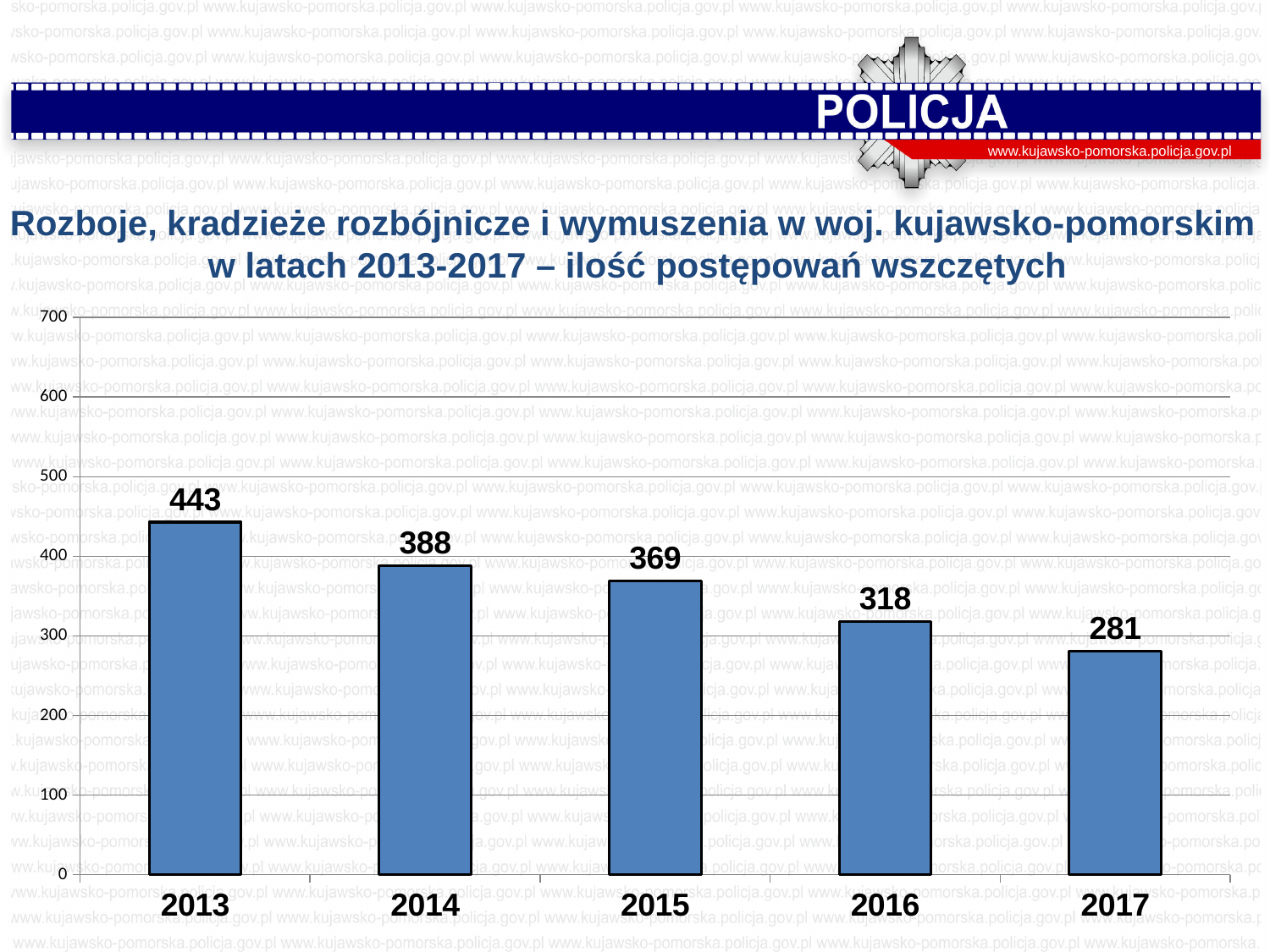
Is the value for 2015 greater or less than 400? less What is the value for 2013? 443 What is the difference between the values for 2016 and 2017? 37 What is the value for 2015? 369 Which year has the highest value? 2013 What is the difference between the values for 2013 and 2014? 55 How many years are shown on the x axis? 5 Do the values rise or fall from 2013 to 2017? fall What kind of chart is shown on the slide? bar chart Which is larger, the value for 2014 or the value for 2016? 2014 What is the value for 2017? 281 Which year has the lowest value? 2017